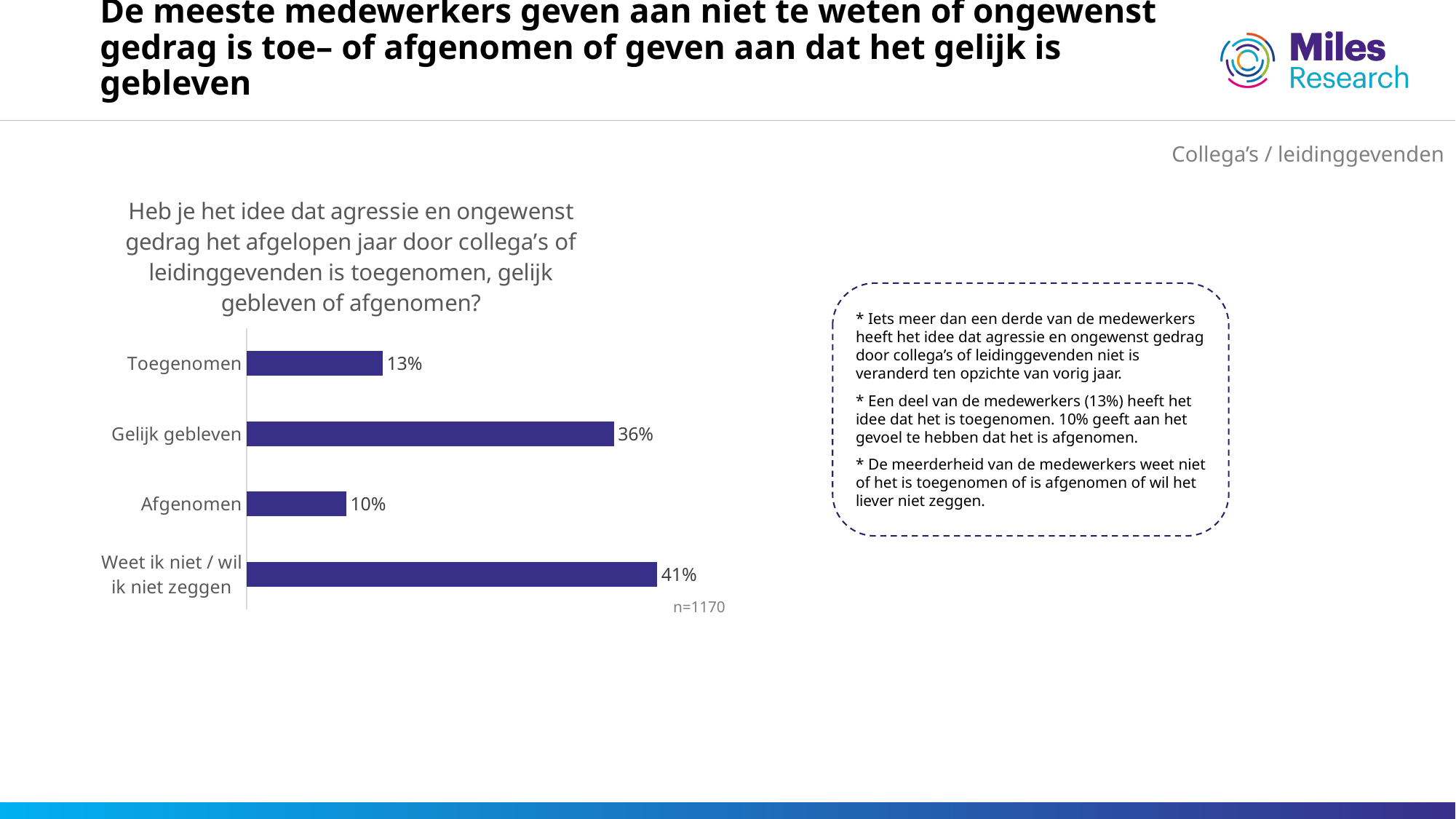
What is the value for Weet ik niet / wil ik niet zeggen? 41% What kind of chart is shown on the slide? Bar chart Which category has the highest value? Weet ik niet / wil ik niet zeggen What is the value for Toegenomen? 13% Which is larger, the value for Toegenomen or the value for Afgenomen? Toegenomen What is the difference between the values for Gelijk gebleven and Toegenomen? 23% What is the value for Gelijk gebleven? 36% How many categories are shown in the chart? 4 What sample size (n) is shown below the chart? n=1170 What is the value for Afgenomen? 10% Which category has the lowest value? Afgenomen What is the difference between the values for Weet ik niet / wil ik niet zeggen and Afgenomen? 31%